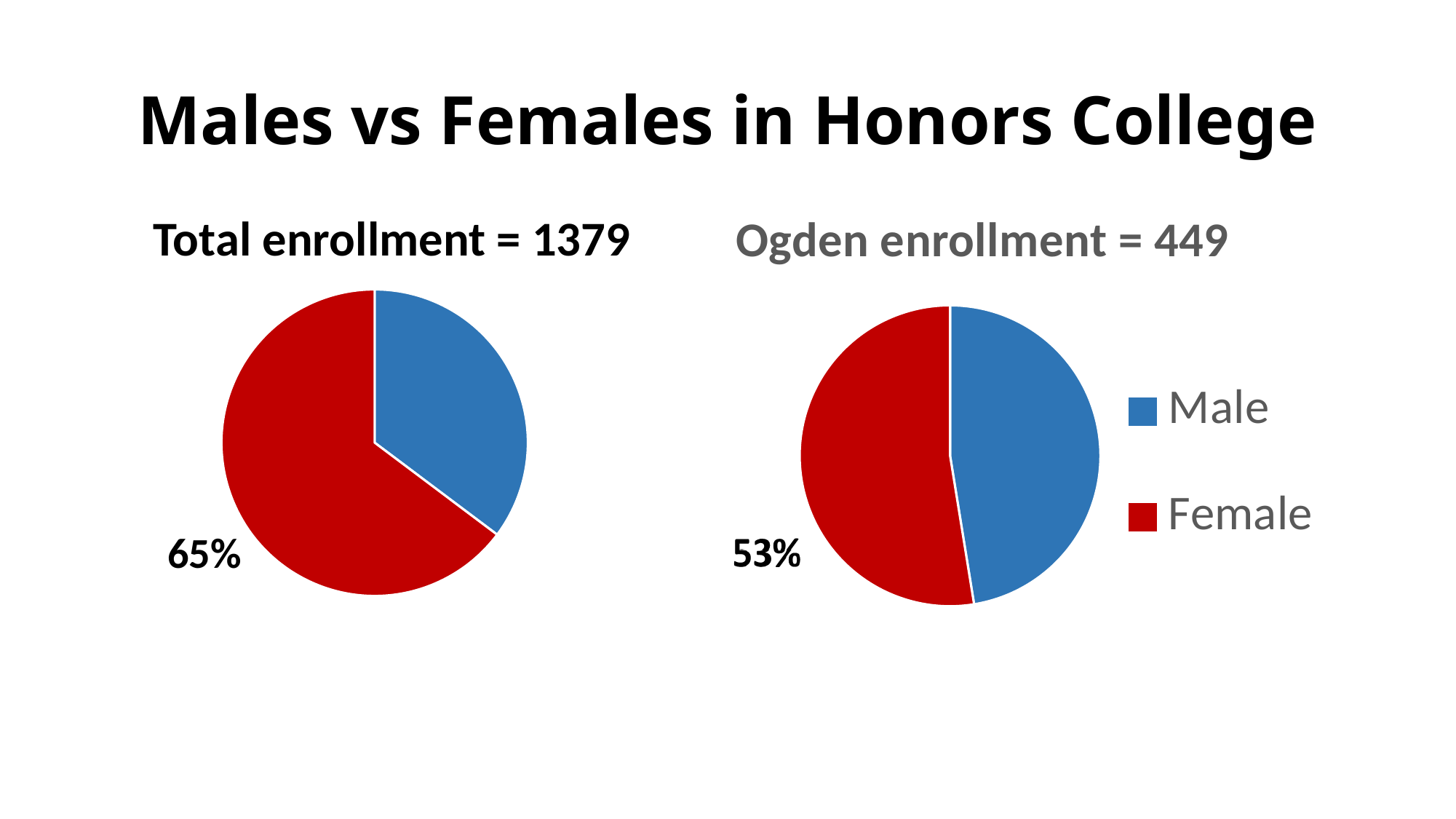
How many entries does the legend list? 2 What kind of chart is used on this slide? Pie chart In the 'Total enrollment = 1379' chart, which slice is the smallest? Male In the 'Ogden enrollment = 449' chart, which slice is the largest? Female What colour represents Female in the legend? Red In the 'Total enrollment = 1379' chart, which slice is the largest? Female What is the difference between the Female share in the 'Total enrollment = 1379' chart and the Female share in the 'Ogden enrollment = 449' chart? 12% In the 'Total enrollment = 1379' chart, which slice is larger, Male or Female? Female Which chart has the larger Female share, 'Total enrollment = 1379' or 'Ogden enrollment = 449'? Total enrollment = 1379 In the 'Ogden enrollment = 449' chart, what share of the pie is Female? 53% In the 'Total enrollment = 1379' chart, what share of the pie is Female? 65% How many slices does the 'Ogden enrollment = 449' pie chart have? 2